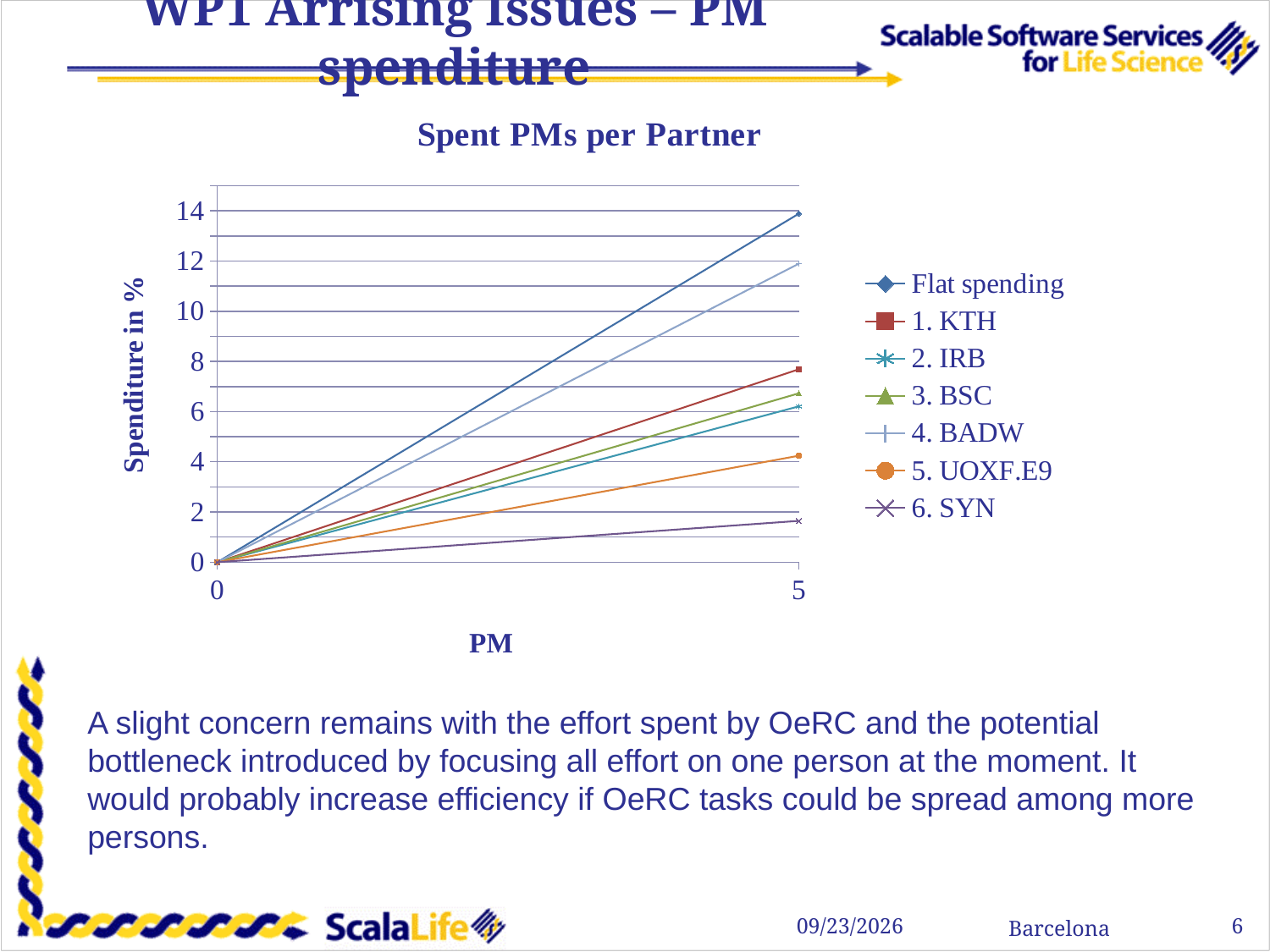
Which series has the highest value at PM = 5? Flat spending Is the value for 4. BADW at PM = 5 greater or less than 10? greater What kind of chart is shown on the slide? line chart Is the value for 1. KTH at PM = 5 greater or less than 8? less Which series has the lowest value at PM = 5? 6. SYN Which is larger at PM = 5, the value for 1. KTH or the value for 5. UOXF.E9? 1. KTH What is the label of the y axis of the chart? Spenditure in % Do the values for 4. BADW rise or fall as PM increases from 0 to 5? rise How many series does the legend of the chart list? 7 Is the value for 6. SYN at PM = 5 greater or less than 2? less What is the title of the chart? Spent PMs per Partner